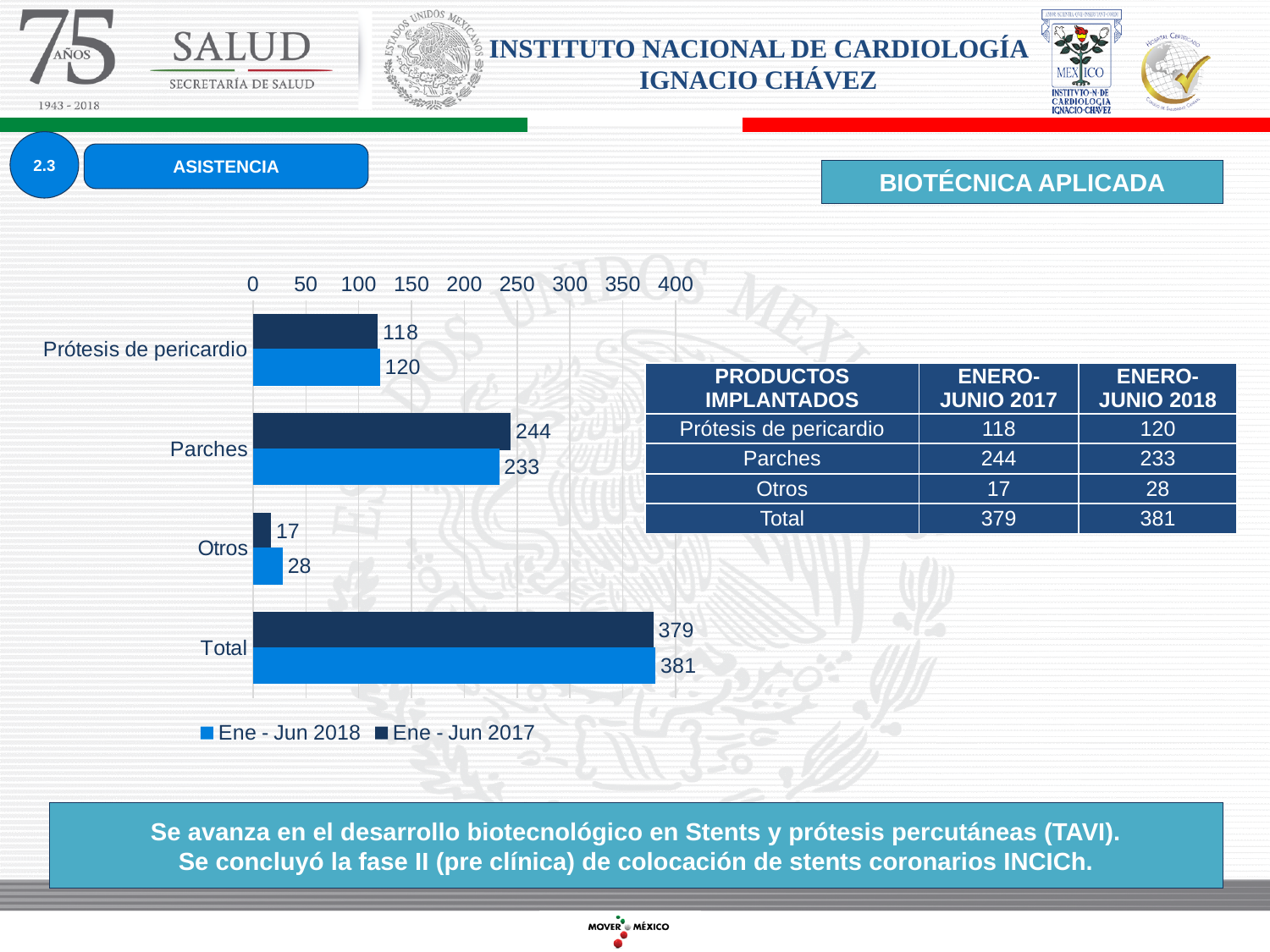
What is the value for Prótesis de pericardio in the Ene - Jun 2018 series? 120 How many categories are plotted on the chart? 4 Excluding Total, which category has the lowest value in the Ene - Jun 2017 series? Otros What kind of chart is shown on the slide? bar chart What is the difference between the Ene - Jun 2017 and Ene - Jun 2018 values for Parches? 11 Which is larger for Otros: the Ene - Jun 2018 value or the Ene - Jun 2017 value? Ene - Jun 2018 What is the value for Parches in the Ene - Jun 2017 series? 244 What is the value for Total in the Ene - Jun 2017 series? 379 What is the value for Otros in the Ene - Jun 2018 series? 28 Which colour represents the Ene - Jun 2017 series in the chart? dark blue How many series does the chart legend list? 2 Excluding Total, which category has the highest value in the Ene - Jun 2018 series? Parches